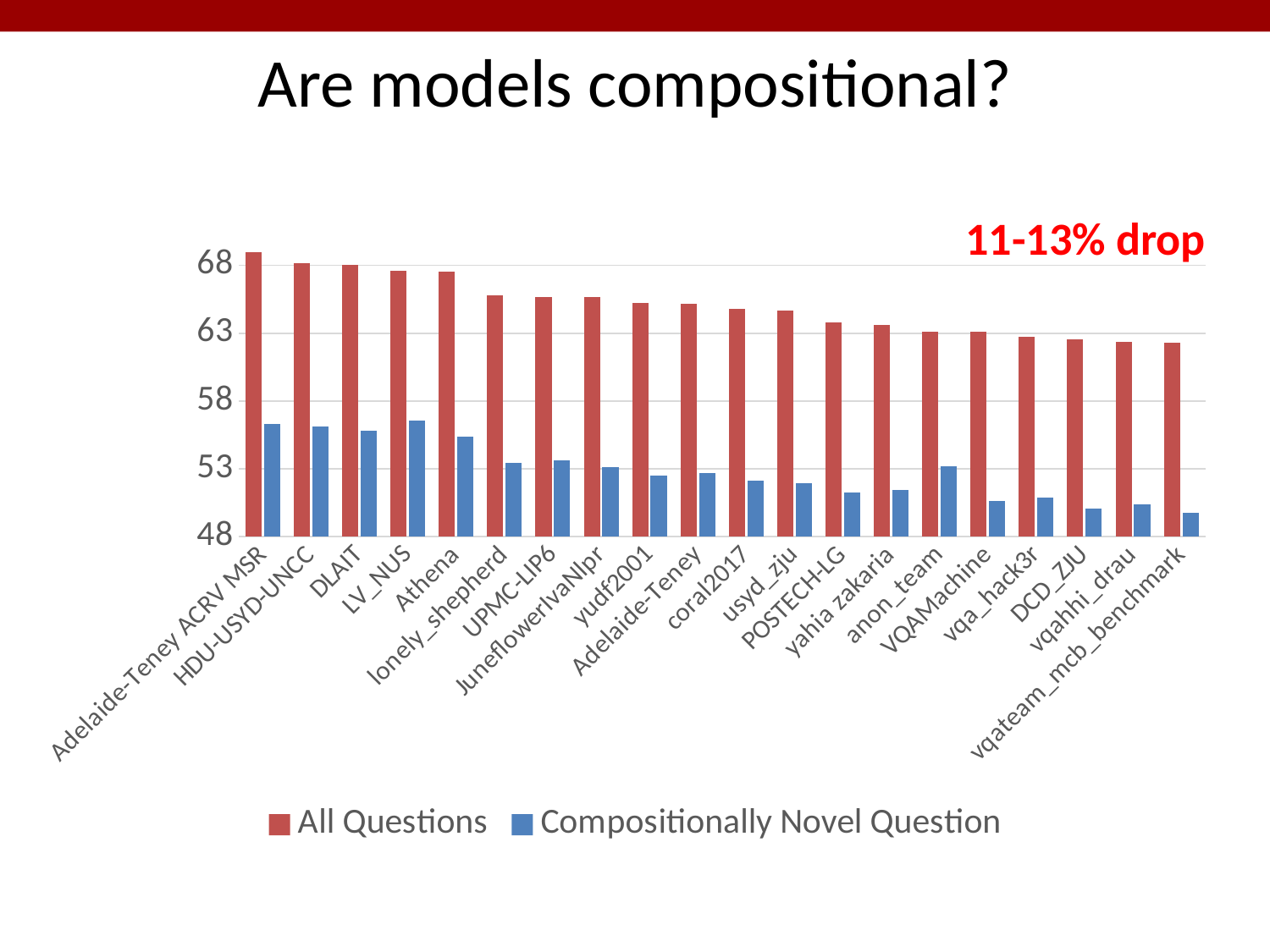
How many series does the legend list? 2 Which team has the highest All Questions value? Adelaide-Teney ACRV MSR What kind of chart is shown on the slide? bar chart Is the All Questions value for lonely_shepherd greater or less than 63? greater Is the Compositionally Novel Question value for vqa_hack3r greater or less than 53? less What colour are the bars for the Compositionally Novel Question series? blue How many teams (categories) are shown on the x axis? 20 Do the All Questions values rise or fall from left to right along the x axis? fall Is the Compositionally Novel Question value for DLAIT greater or less than 58? less For Athena, which series has the larger value: All Questions or Compositionally Novel Question? All Questions